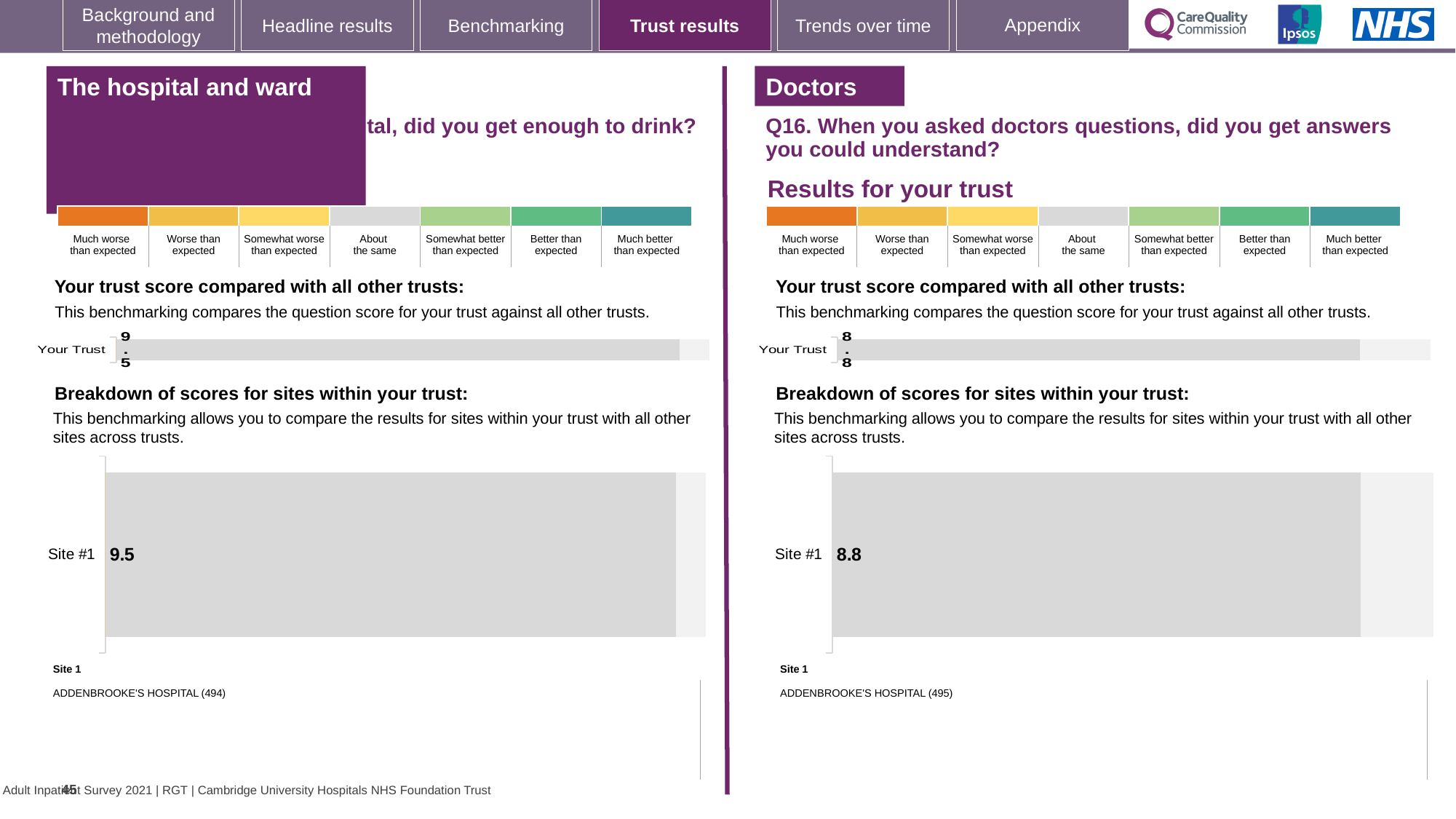
On the right-hand 'Your trust score compared with all other trusts' chart under Q16, what is the value for Your Trust? 8.8 On the right-hand 'Breakdown of scores for sites within your trust' chart under Q16, what is the value for Site #1? 8.8 What kind of chart is used for the 'Your Trust' score on the left-hand side of the slide? Bar chart Which is larger: the Your Trust score on the left-hand chart or the Your Trust score on the right-hand Q16 chart? The left-hand chart (9.5) Which hospital is listed as Site 1 beneath the left-hand breakdown chart? ADDENBROOKE'S HOSPITAL (494) On the left-hand 'Breakdown of scores for sites within your trust' chart, what is the value for Site #1? 9.5 On the left-hand 'Your trust score compared with all other trusts' chart, what is the value for Your Trust? 9.5 How many sites are shown on the right-hand 'Breakdown of scores for sites within your trust' chart under Q16? 1 Which hospital is listed as Site 1 beneath the right-hand Q16 breakdown chart? ADDENBROOKE'S HOSPITAL (495) How many sites are shown on the left-hand 'Breakdown of scores for sites within your trust' chart? 1 What is the difference between the Site #1 score on the left-hand breakdown chart and the Site #1 score on the right-hand Q16 breakdown chart? 0.7 What kind of chart is used for the site breakdown on the right-hand side of the slide under Q16? Bar chart